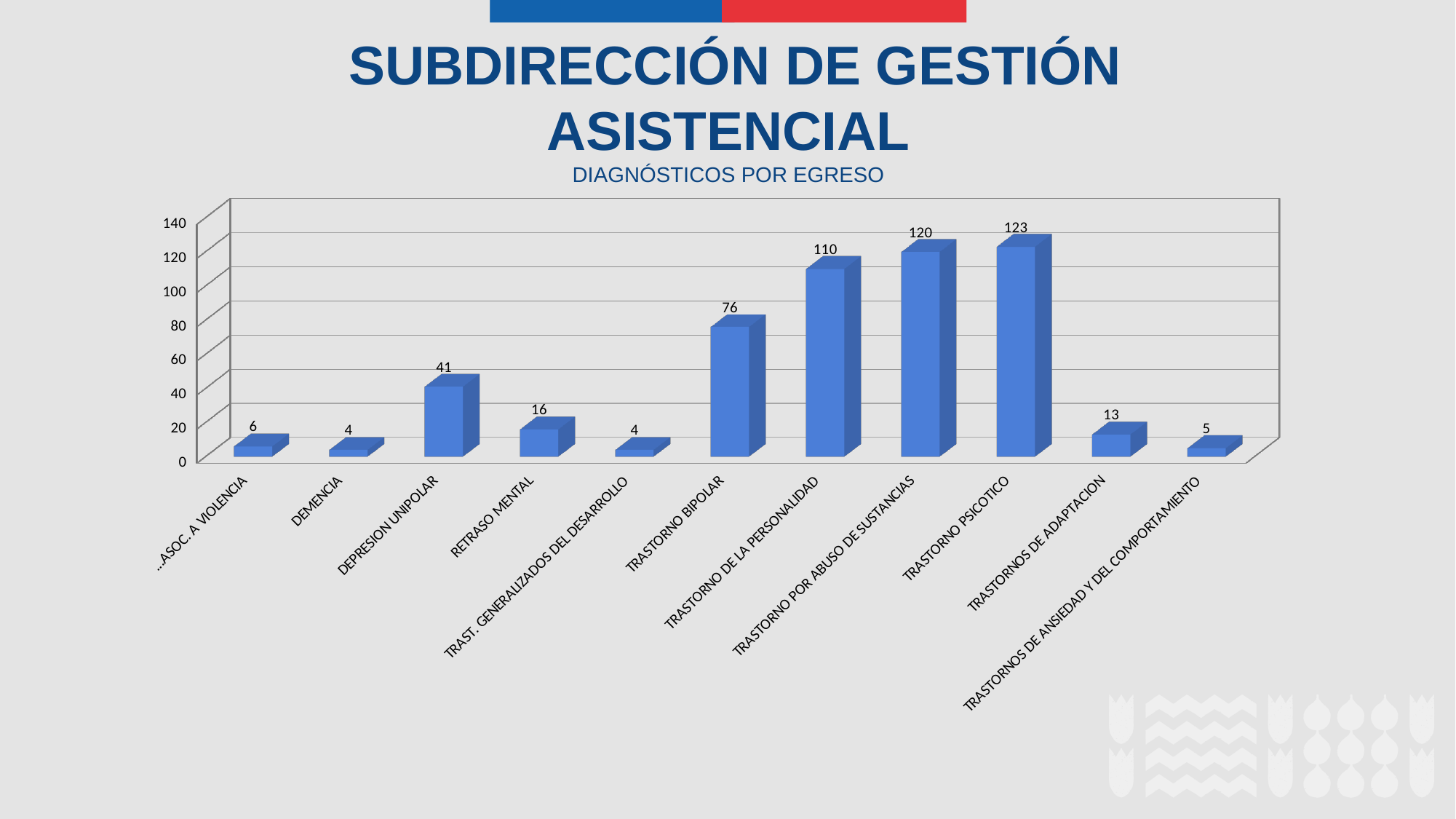
What kind of chart is shown on the slide? bar chart Is the value for TRASTORNO DE LA PERSONALIDAD greater or less than 100? greater How many categories are shown on the x axis? 11 What is the value for DEPRESION UNIPOLAR? 41 What is the value for TRASTORNO PSICOTICO? 123 What is the difference between TRASTORNO POR ABUSO DE SUSTANCIAS and TRASTORNO DE LA PERSONALIDAD? 10 What is the value for TRASTORNO BIPOLAR? 76 Which category has the highest value? TRASTORNO PSICOTICO Which is larger, RETRASO MENTAL or TRASTORNOS DE ADAPTACION? RETRASO MENTAL What is the difference between TRASTORNO PSICOTICO and TRASTORNO BIPOLAR? 47 What is the title of the chart? DIAGNÓSTICOS POR EGRESO What is the value for TRASTORNOS DE ADAPTACION? 13